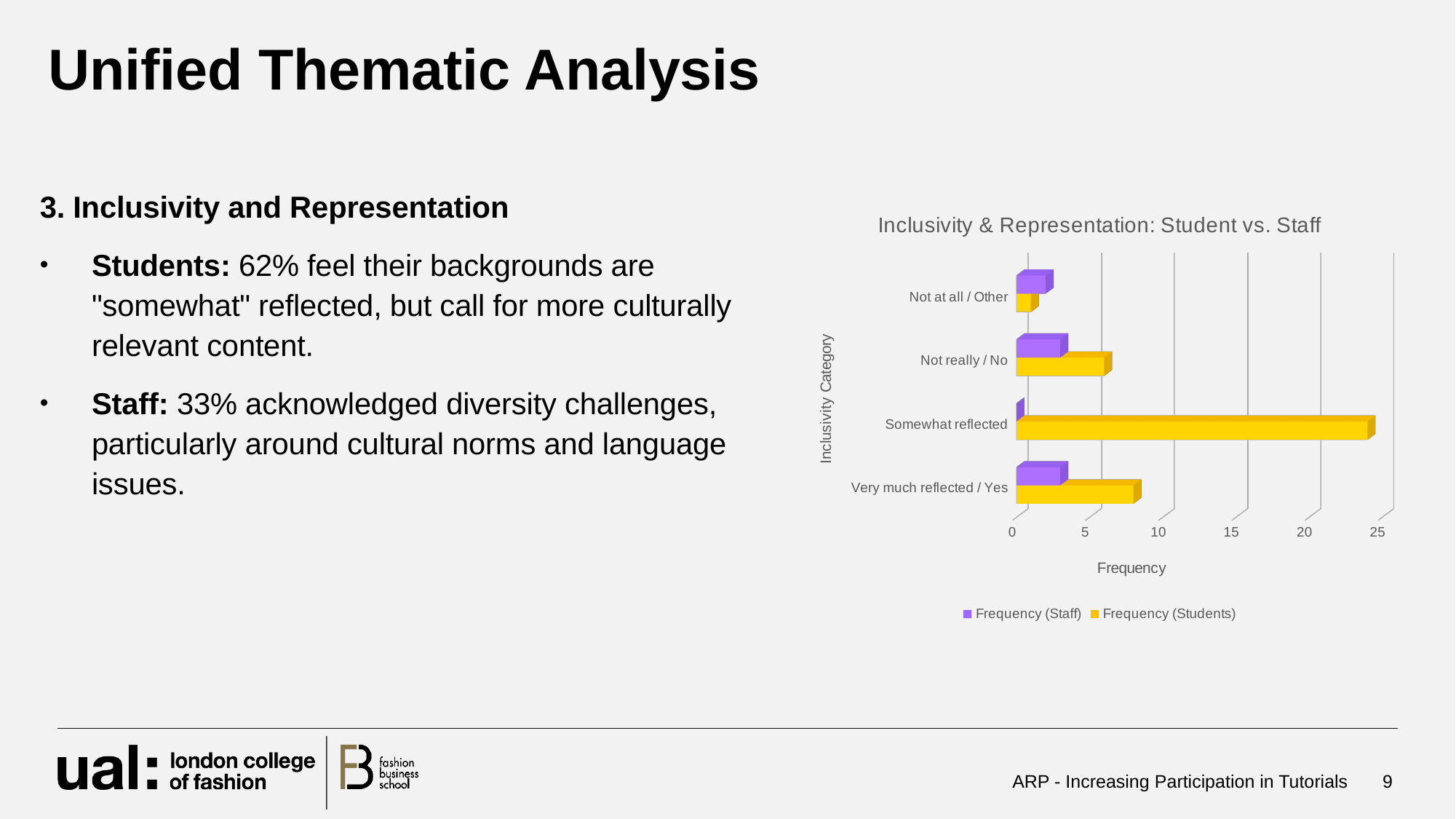
What type of chart is shown on the slide? Bar chart Which colour represents the Frequency (Staff) series? Purple How many series does the chart legend list? 2 Which category has the highest Frequency (Students) value? Somewhat reflected Is the Frequency (Students) value for Very much reflected / Yes greater or less than 10? less What is the title of the chart? Inclusivity & Representation: Student vs. Staff Which category has the lowest Frequency (Students) value? Not at all / Other Is the Frequency (Staff) value for Not really / No greater or less than 5? less For Somewhat reflected, which is larger: Frequency (Staff) or Frequency (Students)? Frequency (Students) Is the Frequency (Students) value for Somewhat reflected greater or less than 20? greater How many inclusivity categories are shown on the chart? 4 Which category has the lowest Frequency (Staff) value? Somewhat reflected